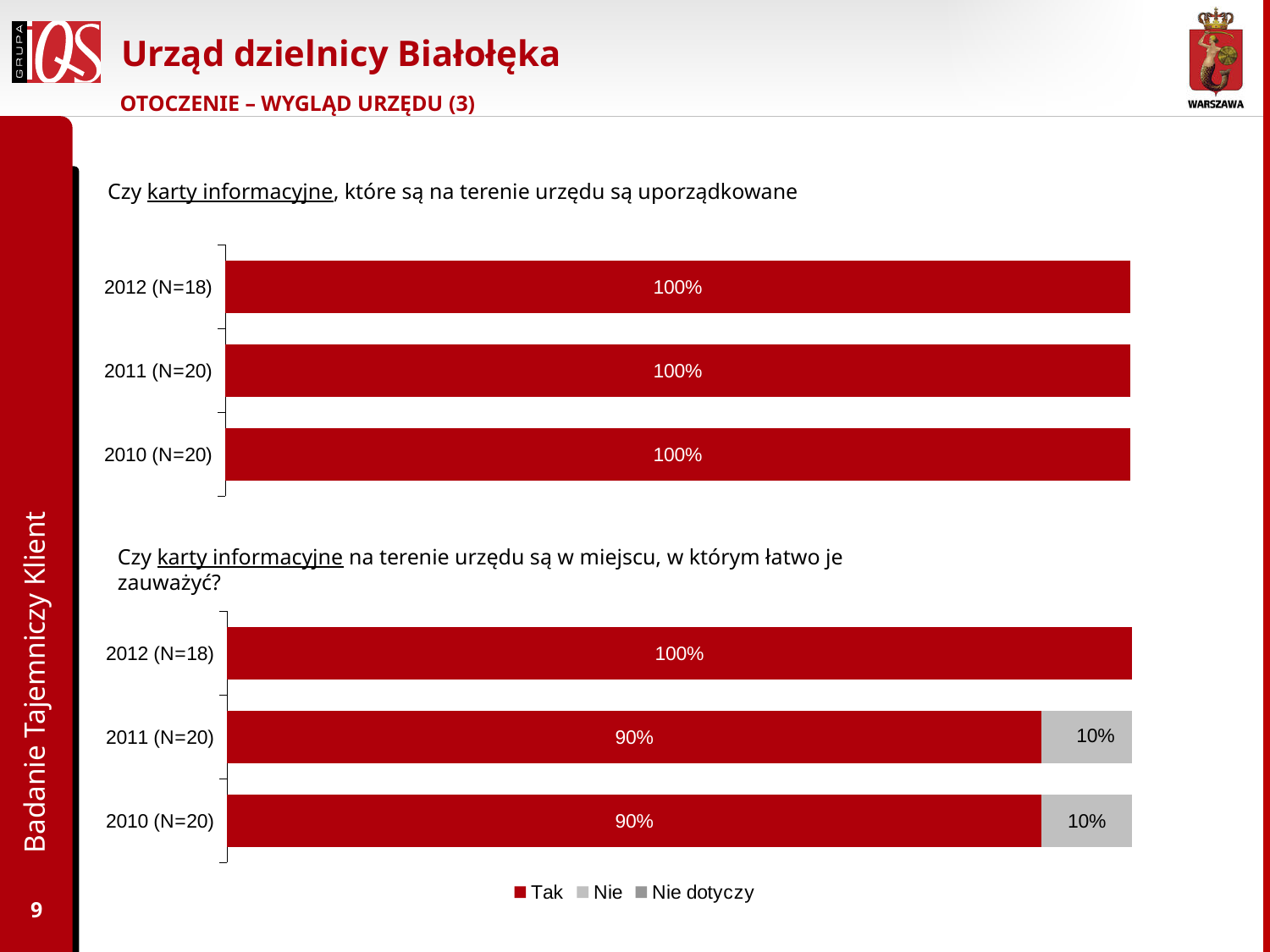
In the bottom chart ("Czy karty informacyjne na terenie urzędu są w miejscu, w którym łatwo je zauważyć?"), what is the "Nie" value for 2010 (N=20)? 10% In the bottom chart ("Czy karty informacyjne na terenie urzędu są w miejscu, w którym łatwo je zauważyć?"), what is the difference between the "Tak" value for 2012 (N=18) and the "Tak" value for 2011 (N=20)? 10% In the bottom chart ("Czy karty informacyjne na terenie urzędu są w miejscu, w którym łatwo je zauważyć?"), what is the total of the 2011 (N=20) bar? 100% In the bottom chart ("Czy karty informacyjne na terenie urzędu są w miejscu, w którym łatwo je zauważyć?"), which year has the highest "Tak" value? 2012 (N=18) How many year categories are shown in the top chart ("Czy karty informacyjne, które są na terenie urzędu są uporządkowane")? 3 What type of chart is the bottom chart ("Czy karty informacyjne na terenie urzędu są w miejscu, w którym łatwo je zauważyć?")? Stacked bar chart In the bottom chart ("Czy karty informacyjne na terenie urzędu są w miejscu, w którym łatwo je zauważyć?"), is the "Tak" value for 2010 (N=20) larger or smaller than the "Tak" value for 2012 (N=18)? smaller What are the three legend entries shown at the bottom of the slide? Tak, Nie, Nie dotyczy In the top chart ("Czy karty informacyjne, które są na terenie urzędu są uporządkowane"), what is the value shown for 2010 (N=20)? 100% How many series does the legend at the bottom of the slide list? 3 In the bottom chart ("Czy karty informacyjne na terenie urzędu są w miejscu, w którym łatwo je zauważyć?"), what is the "Tak" value for 2011 (N=20)? 90% In the bottom chart ("Czy karty informacyjne na terenie urzędu są w miejscu, w którym łatwo je zauważyć?"), what is the "Tak" value for 2012 (N=18)? 100%